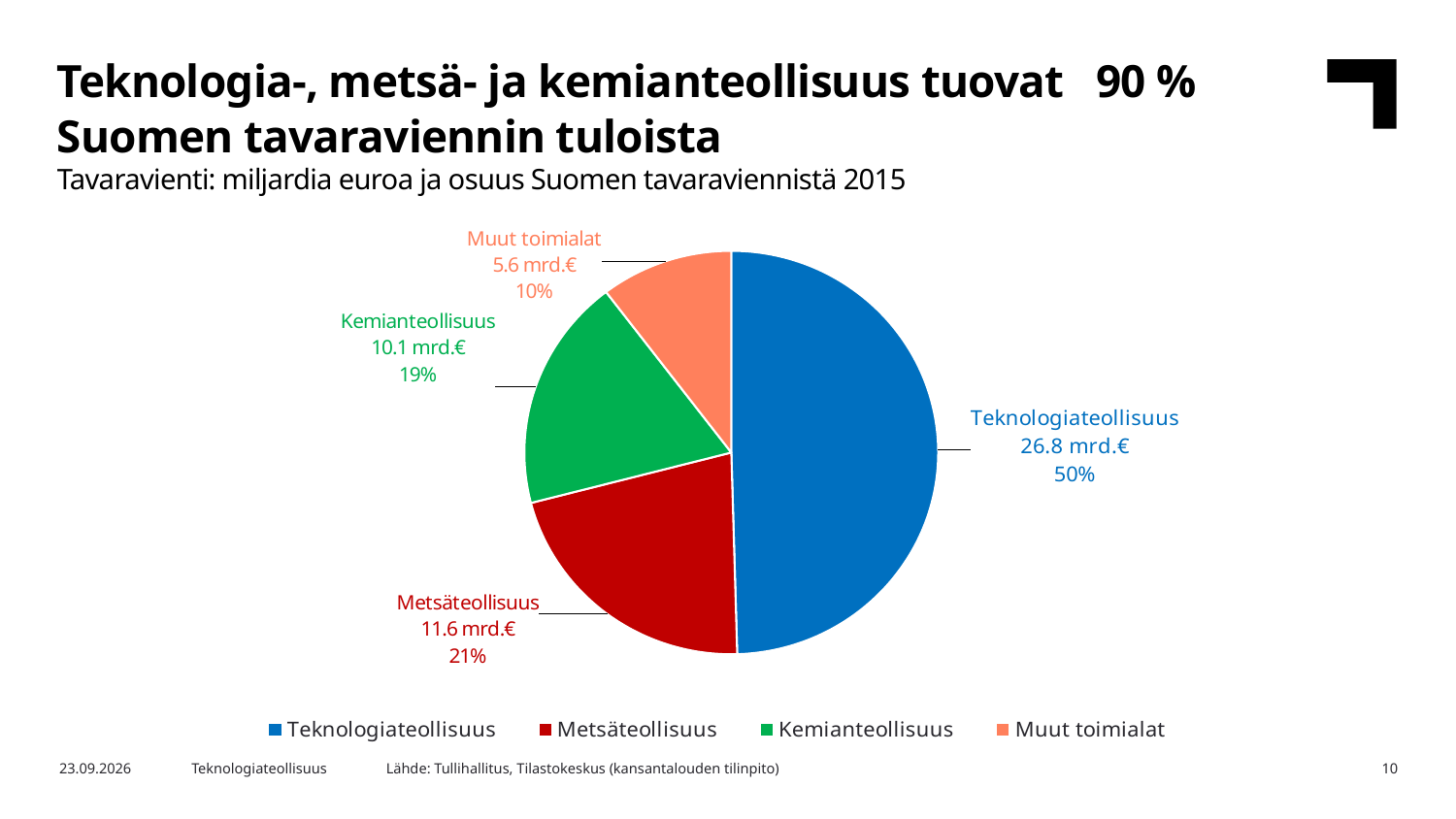
What share of the pie does Teknologiateollisuus represent? 50% What is the value for Kemianteollisuus in mrd.€? 10.1 mrd.€ What is the value for Metsäteollisuus in mrd.€? 11.6 mrd.€ Which colour represents Metsäteollisuus in the legend? red What is the difference in mrd.€ between Teknologiateollisuus and Metsäteollisuus? 15.2 mrd.€ Which category has the largest slice? Teknologiateollisuus What is the value for Teknologiateollisuus in mrd.€? 26.8 mrd.€ What kind of chart is shown on the slide? pie chart How many categories does the pie chart have? 4 What share of the pie does Kemianteollisuus represent? 19% Which category has the smallest slice? Muut toimialat What is the value for Muut toimialat in mrd.€? 5.6 mrd.€